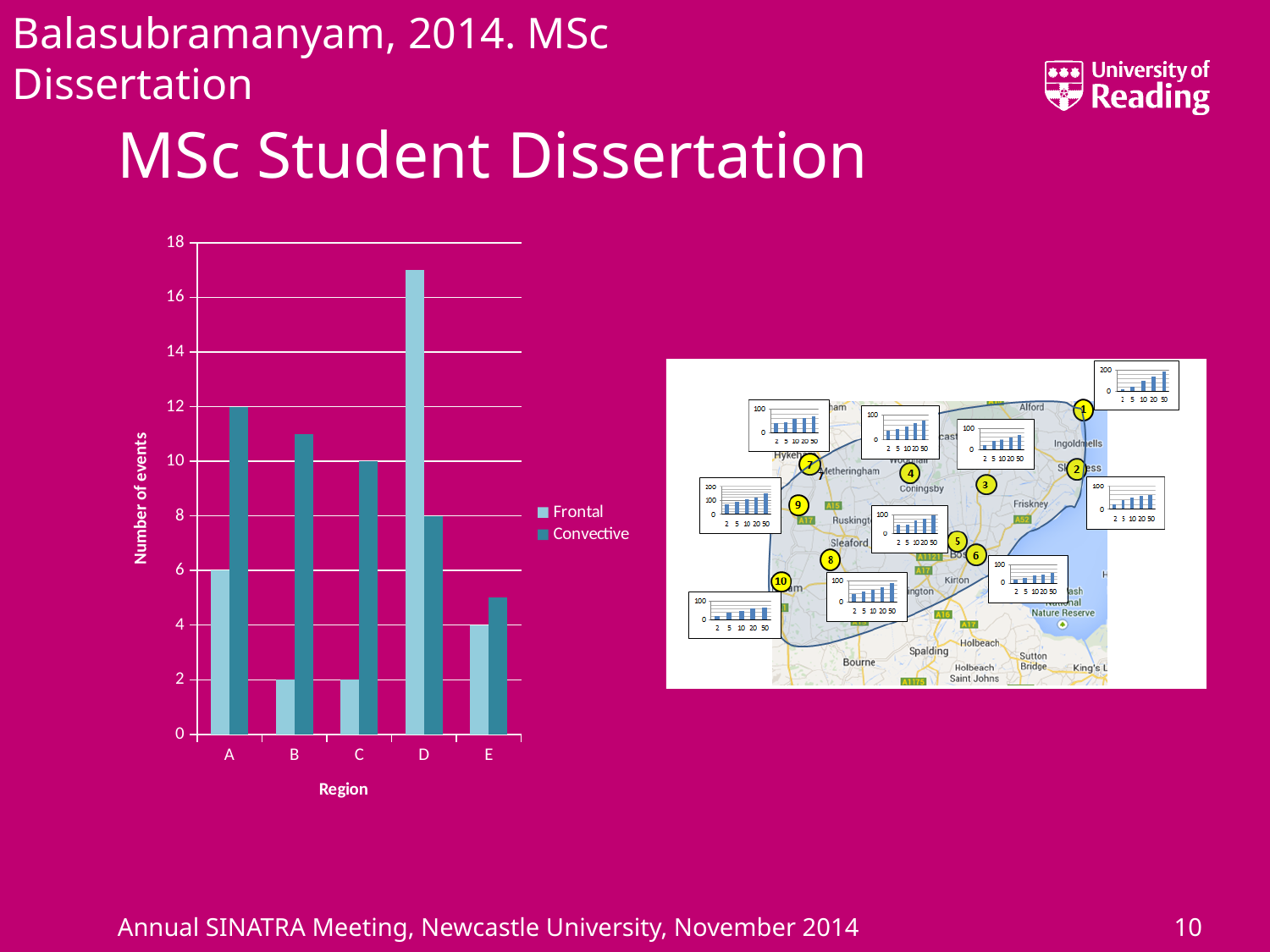
In the bar chart on the left, how many regions are shown on the x axis? 5 In the bar chart on the left, which is larger for region B, Frontal or Convective events? Convective In the bar chart on the left, what is the number of Convective events for region A? 12 In the bar chart on the left, what type of chart is it? bar chart In the bar chart on the left, is the number of Frontal events for region D greater or less than 16? greater In the bar chart on the left, what is the number of Frontal events for region E? 4 In the bar chart on the left, how many series does the legend list? 2 In the bar chart on the left, which region has the highest number of Frontal events? D In the bar chart on the left, what is the number of Frontal events for region A? 6 In the bar chart on the left, which region has the lowest number of Convective events? E In the bar chart on the left, what is the number of Convective events for region C? 10 In the bar chart on the left, what is the label of the y axis? Number of events